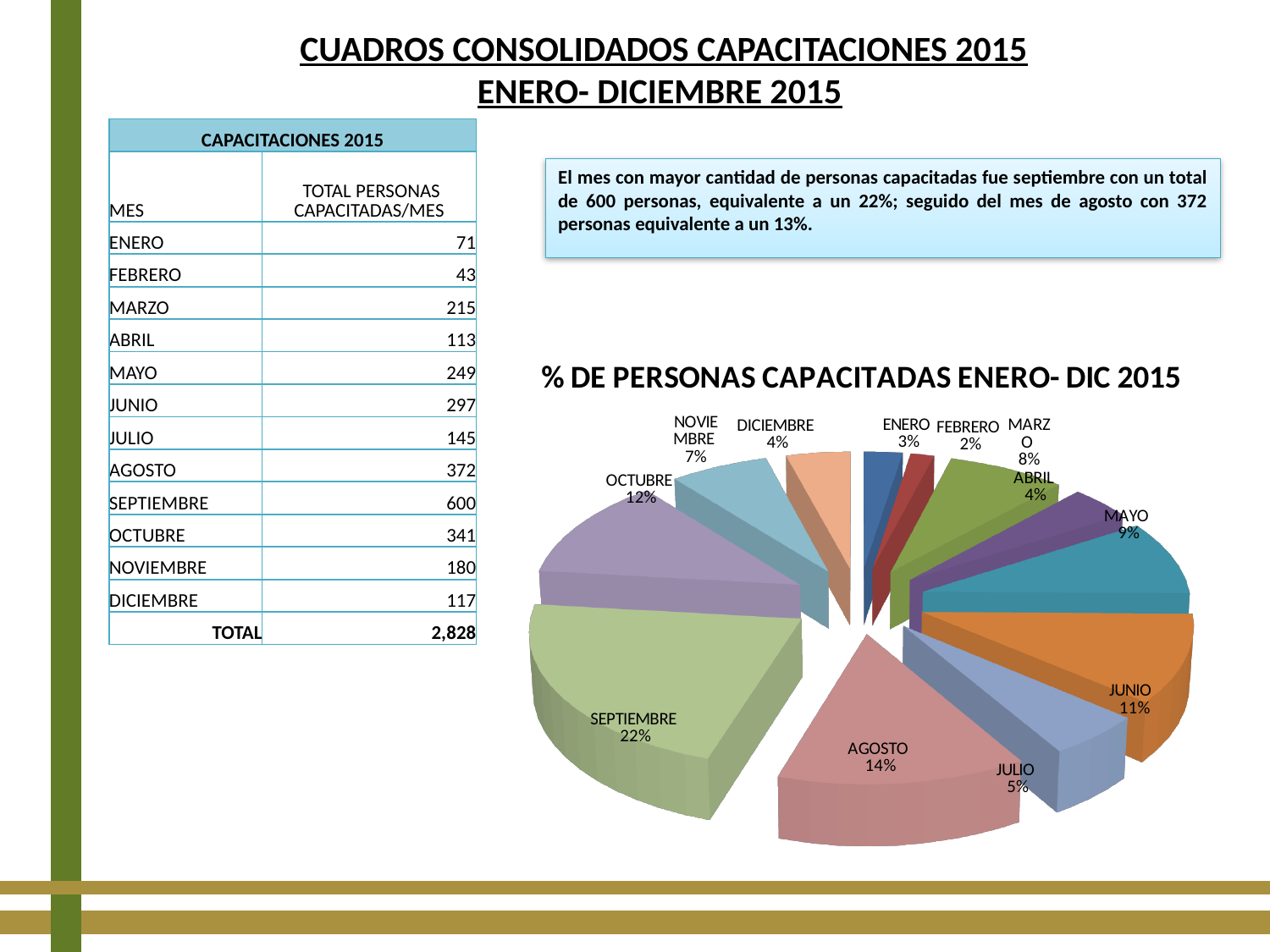
What percentage is shown for OCTUBRE? 12% Which month has the largest slice of the pie? SEPTIEMBRE What percentage is shown for NOVIEMBRE? 7% What percentage is shown for MAYO? 9% What is the chart's title? % DE PERSONAS CAPACITADAS ENERO- DIC 2015 What percentage is shown for AGOSTO? 14% Which month has the smallest slice of the pie? FEBRERO Which slice is larger, OCTUBRE or JUNIO? OCTUBRE What kind of chart is shown on the slide? pie chart What share of the pie does SEPTIEMBRE represent? 22% What is the difference in percentage points between SEPTIEMBRE and AGOSTO? 8 How many slices does the pie chart have? 12